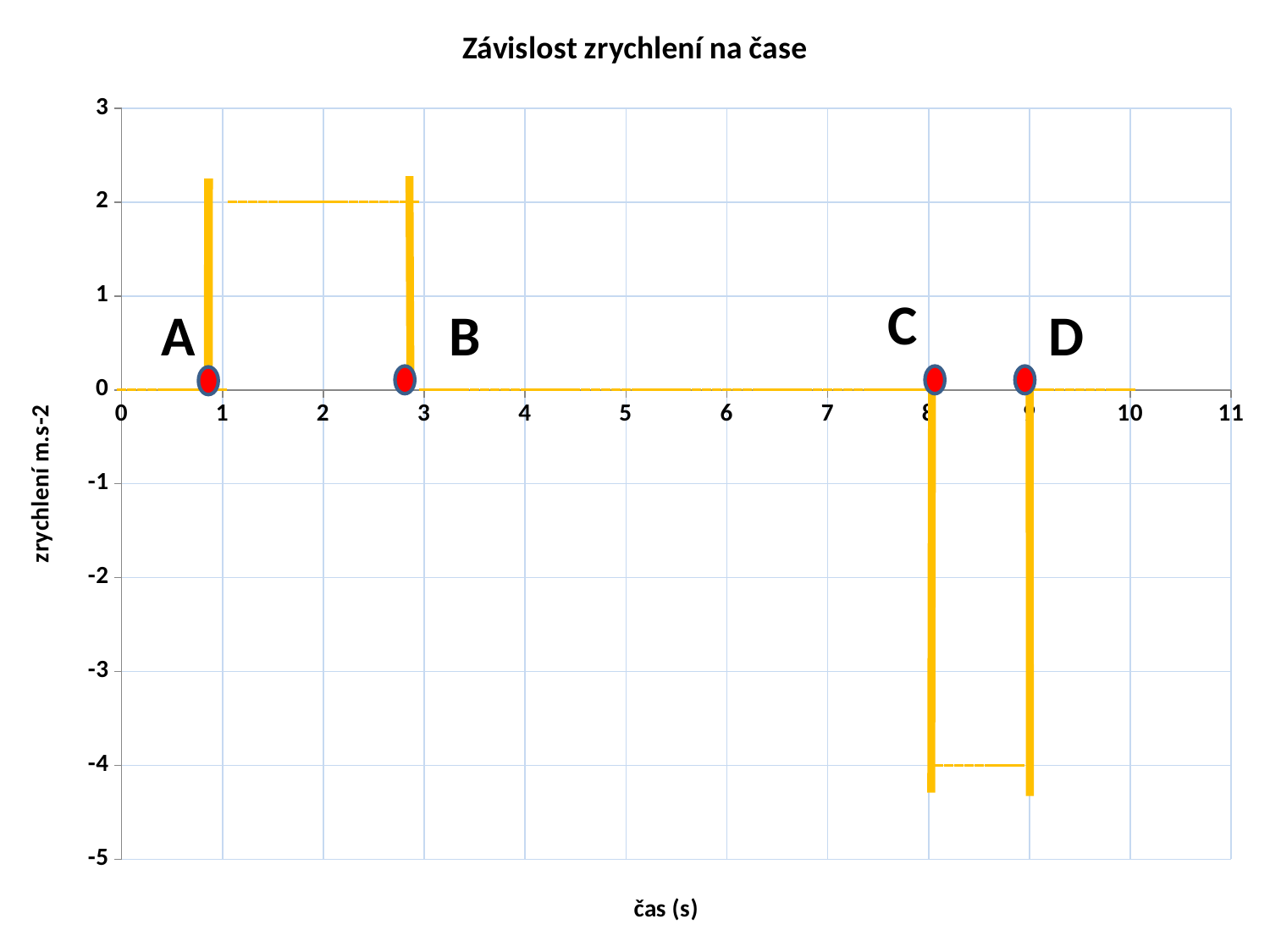
What is the label of the horizontal axis? čas (s) Does the acceleration rise or fall when moving from 7 s to 8.5 s along the x axis? fall Which is larger, the acceleration at 2 s or the acceleration at 8.5 s? the acceleration at 2 s What is the highest value shown on the vertical axis? 3 What kind of chart is shown on the slide? line chart What is the acceleration value between 4 s and 7 s? 0 What value does the acceleration hold between about 8 s and 9 s? -4 Is the acceleration at 2 s greater or less than 1? greater What is the title of the chart? Závislost zrychlení na čase Is the acceleration at 8.5 s greater or less than -3? less What value does the acceleration hold between about 1 s and 3 s? 2 What is the difference between the acceleration plateau at 2 s and the plateau at 8.5 s? 6